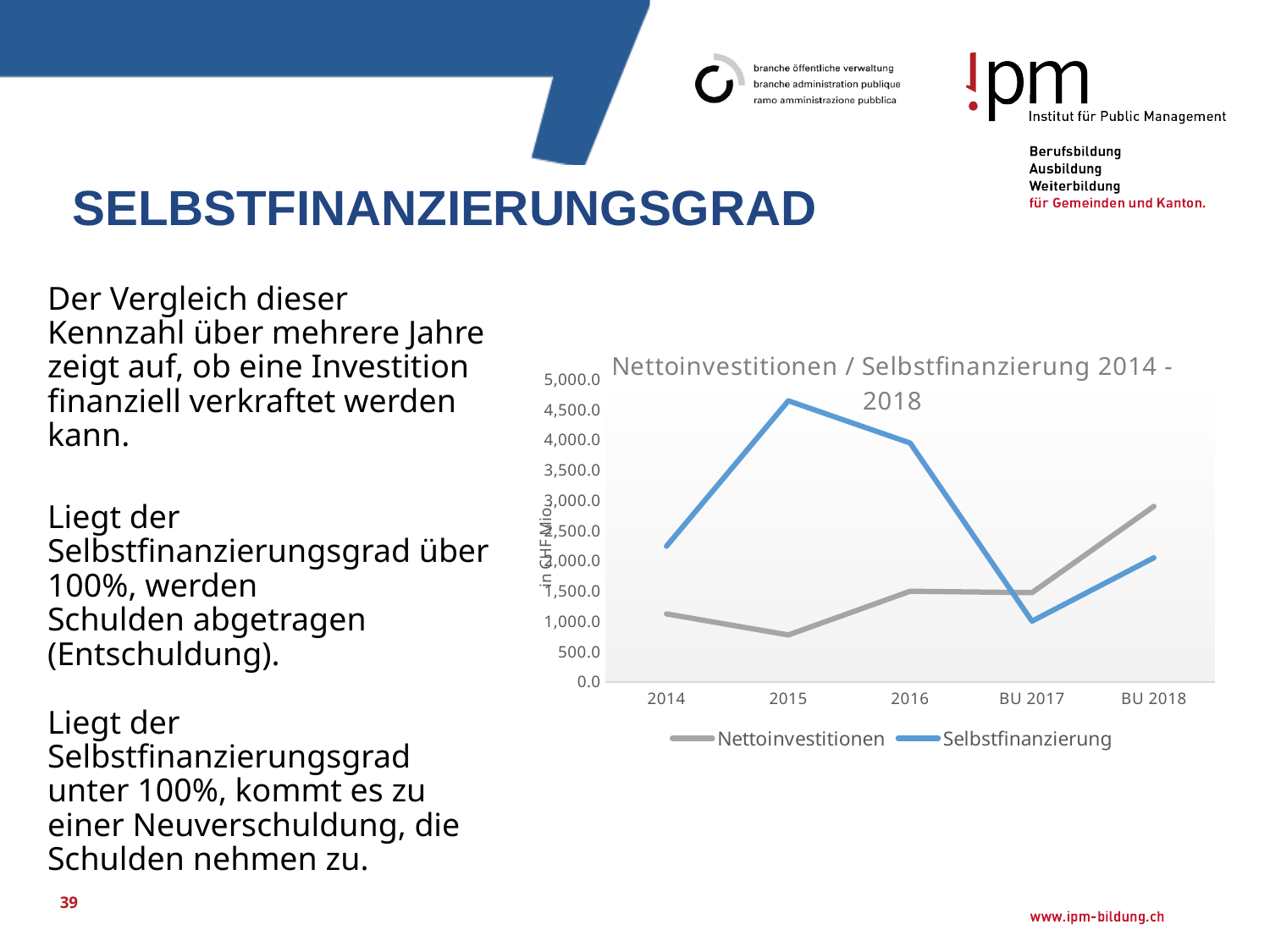
In which year does the Selbstfinanzierung series reach its highest value? 2015 In 2015, which series has the larger value, Nettoinvestitionen or Selbstfinanzierung? Selbstfinanzierung What is the title of the chart? Nettoinvestitionen / Selbstfinanzierung 2014 - 2018 In BU 2018, which series has the larger value, Nettoinvestitionen or Selbstfinanzierung? Nettoinvestitionen How many categories are shown on the x axis of the chart? 5 In which category does the Selbstfinanzierung series reach its lowest value? BU 2017 Is the value for Nettoinvestitionen in 2015 greater or less than 1,000.0? less In which year does the Nettoinvestitionen series reach its lowest value? 2015 In which category does the Nettoinvestitionen series reach its highest value? BU 2018 Is the value for Selbstfinanzierung in 2015 greater or less than 4,000.0? greater How many series does the chart's legend list? 2 What kind of chart is shown on the slide? line chart